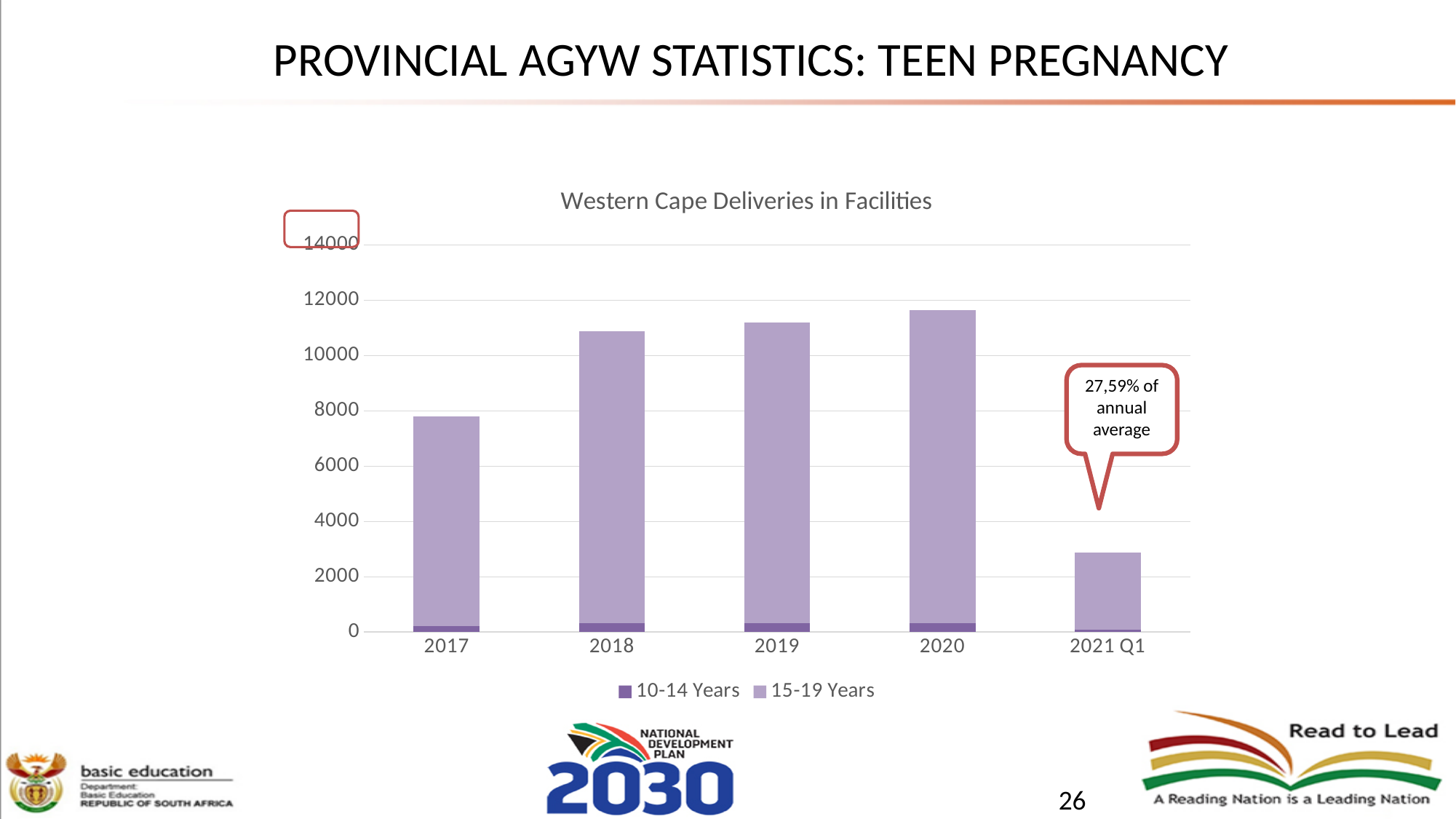
What kind of chart is shown on the slide? Stacked bar chart What is the title of the chart? Western Cape Deliveries in Facilities Is the total value for 2018 greater or less than 10000? greater Which category has the lowest total bar? 2021 Q1 How many series does the legend list? 2 Is the total value for 2021 Q1 greater or less than 4000? less How many categories are shown on the x axis? 5 Is the total value for 2020 greater or less than 12000? less Which category has the highest total bar? 2020 Do the total bar values rise or fall from 2017 to 2020? rise What does the callout next to the 2021 Q1 bar say? 27,59% of annual average